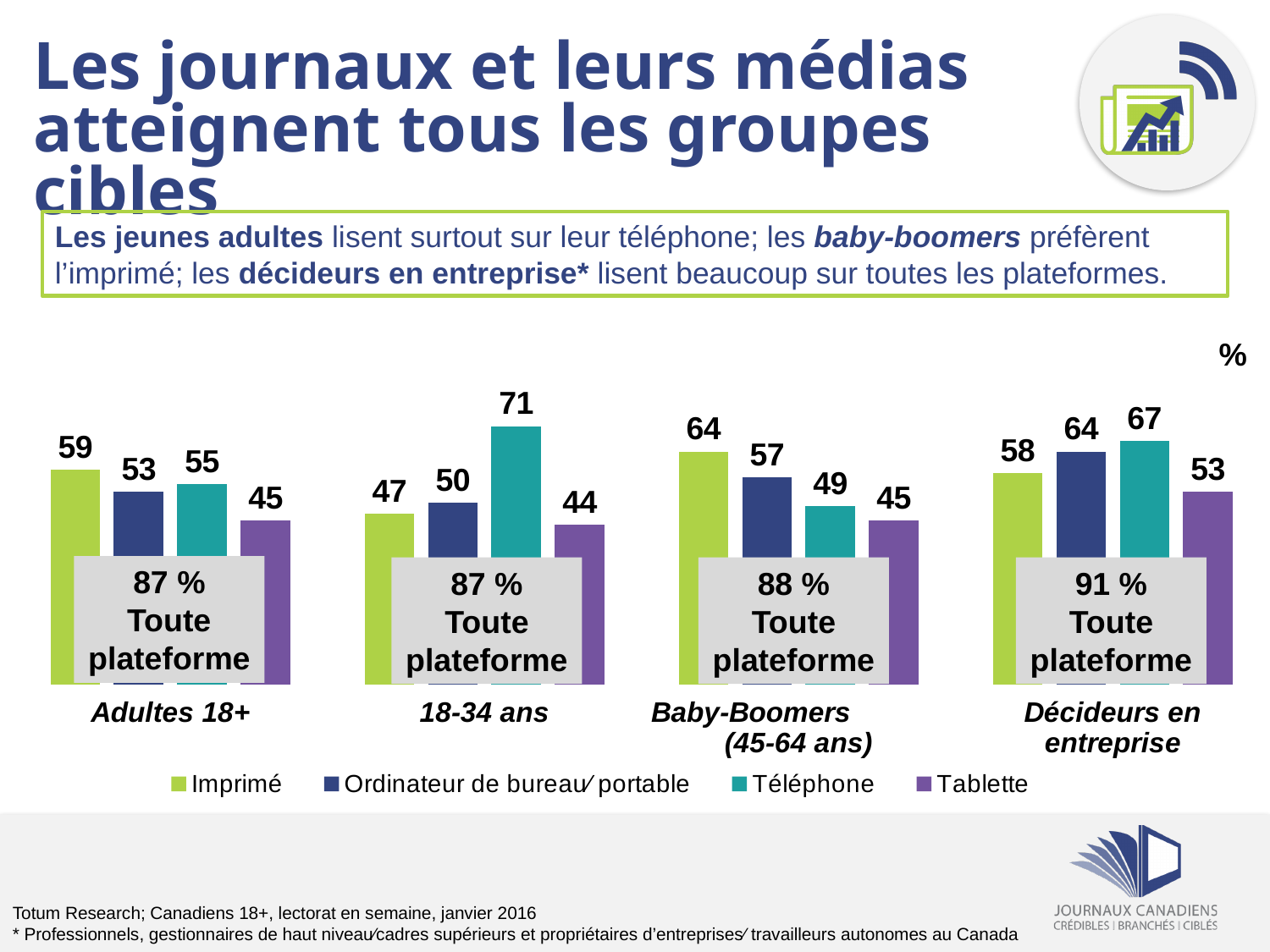
Which platform has the highest value for Adultes 18+? Imprimé Which series is shown in green in the legend? Imprimé Which is larger for Baby-Boomers (45-64 ans): Imprimé or Téléphone? Imprimé How many series does the legend list? 4 What is the value for Téléphone in the 18-34 ans group? 71 What 'Toute plateforme' percentage is shown for Décideurs en entreprise? 91 % What kind of chart is shown on the slide? Bar chart How many groups (categories) are shown on the x axis? 4 What is the value for Imprimé among Baby-Boomers (45-64 ans)? 64 Which platform has the lowest value in the 18-34 ans group? Tablette What is the value for Tablette among Décideurs en entreprise? 53 What is the difference between Téléphone and Imprimé in the 18-34 ans group? 24